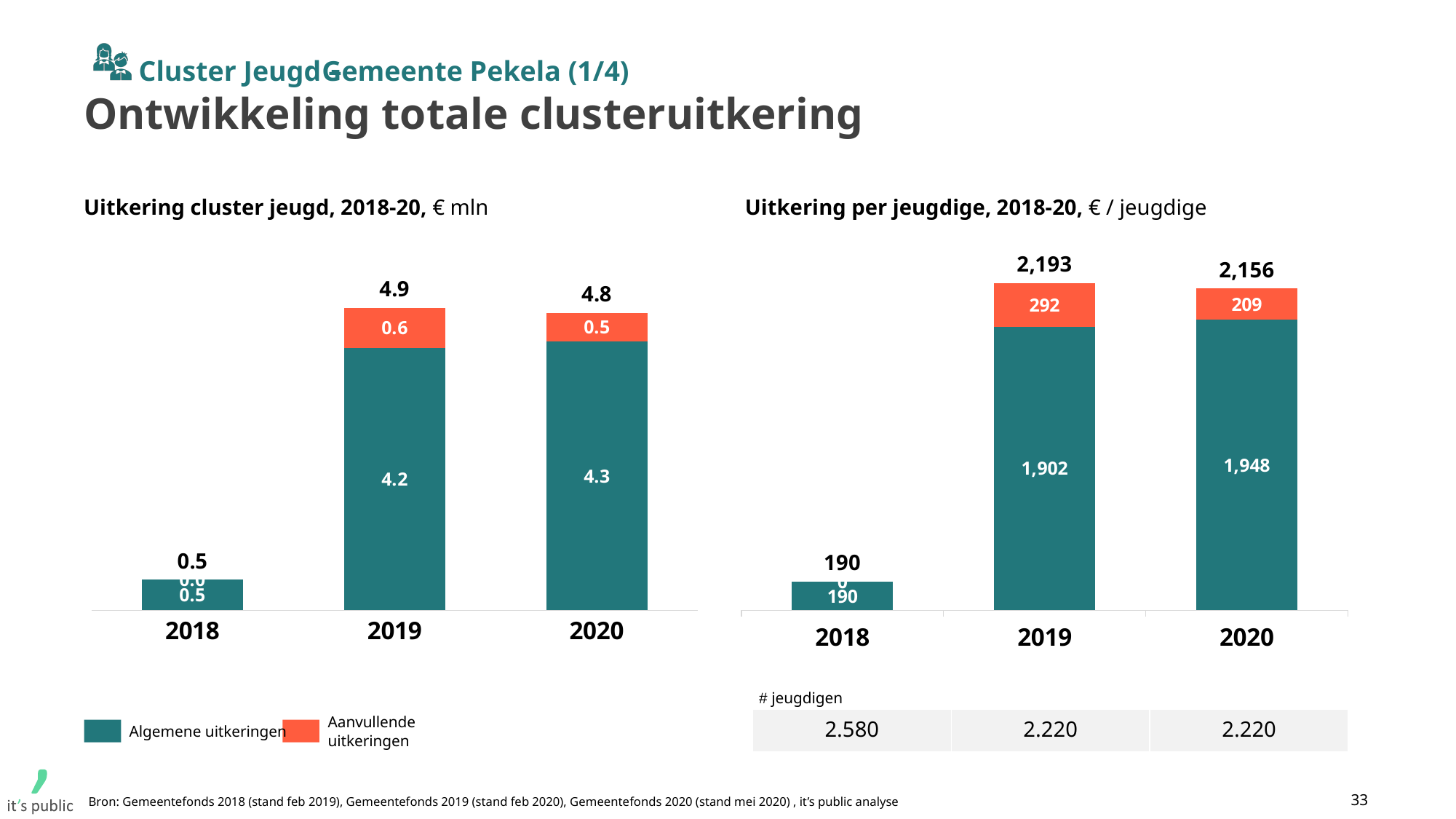
What kind of chart is 'Uitkering per jeugdige, 2018-20'? Stacked bar chart In the chart 'Uitkering per jeugdige, 2018-20', what is the value of Algemene uitkeringen for 2020? 1,948 In the chart 'Uitkering cluster jeugd, 2018-20', what is the value of Algemene uitkeringen for 2019? 4.2 In the chart 'Uitkering cluster jeugd, 2018-20', what is the total of the stacked bar for 2020? 4.8 In the chart 'Uitkering cluster jeugd, 2018-20', what is the value of Aanvullende uitkeringen for 2019? 0.6 In the chart 'Uitkering per jeugdige, 2018-20', is the Algemene uitkeringen value larger in 2019 or 2020? 2020 How many years are shown on the x axis of the chart 'Uitkering cluster jeugd, 2018-20'? 3 In the chart 'Uitkering per jeugdige, 2018-20', what is the difference between the Aanvullende uitkeringen values for 2019 and 2020? 83 How many series does the legend list for the charts on the slide? 2 In the chart 'Uitkering per jeugdige, 2018-20', what is the total for 2019? 2,193 In the chart 'Uitkering per jeugdige, 2018-20', which year has the highest total? 2019 In the chart 'Uitkering cluster jeugd, 2018-20', which year has the lowest total? 2018